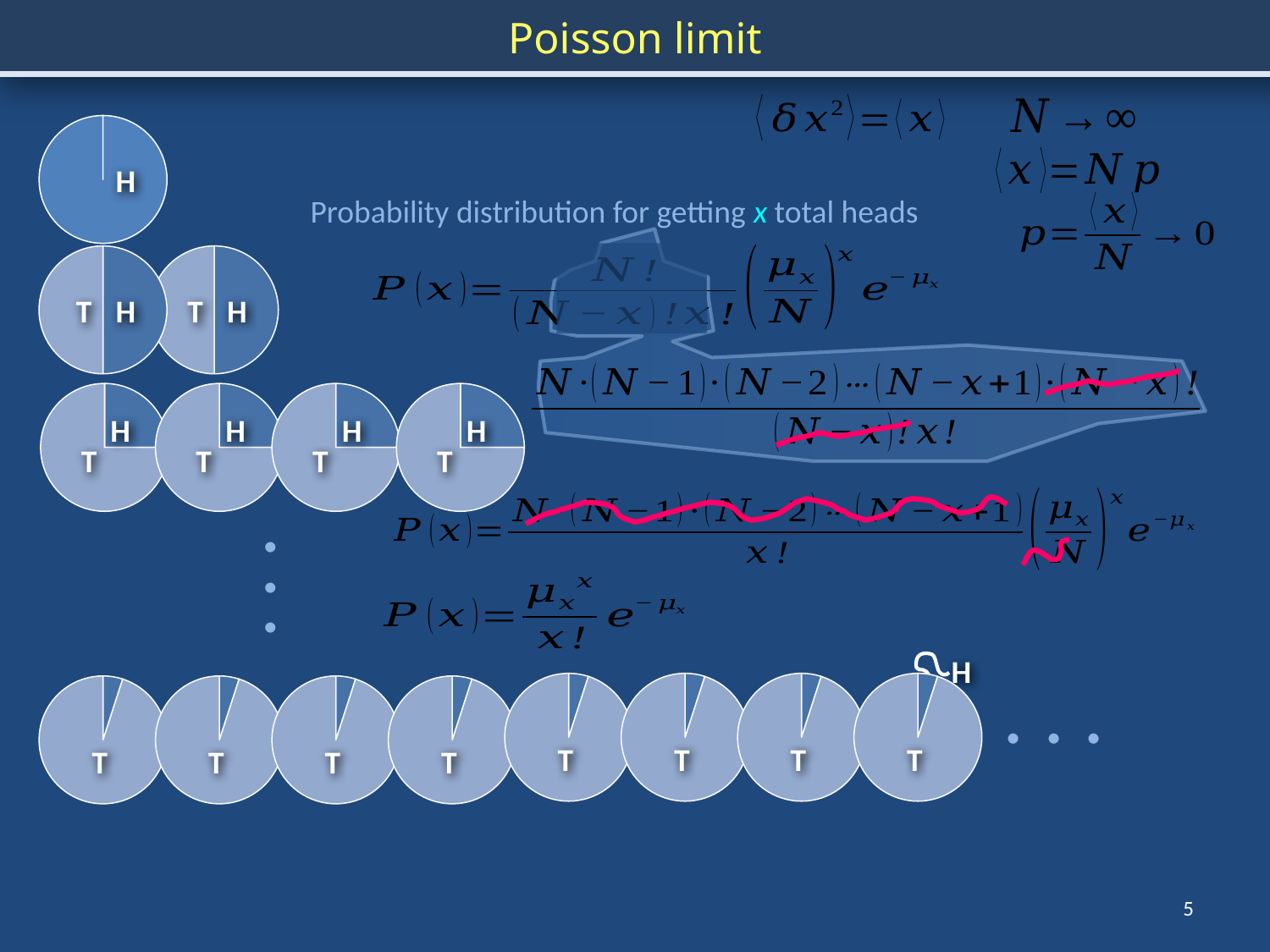
How many pie charts are shown in the third row (the row with H and T slices where T is the larger slice)? 4 How many pie charts are shown in the second row (the row with T and H halves)? 2 In the pie charts of the bottom row, which slice is the largest? T What is the title of the slide containing the pie charts? Poisson limit In the pie charts of the third row, which slice is larger, T or H? T What is the only label shown in the single pie chart at the top left of the slide? H What kind of chart is used to represent each coin on the slide? pie chart In the pie charts of the bottom row, which slice is the smallest? H How many pie charts are shown in the bottom row of the slide? 8 In the pie charts of the bottom row, which slice is larger, T or H? T